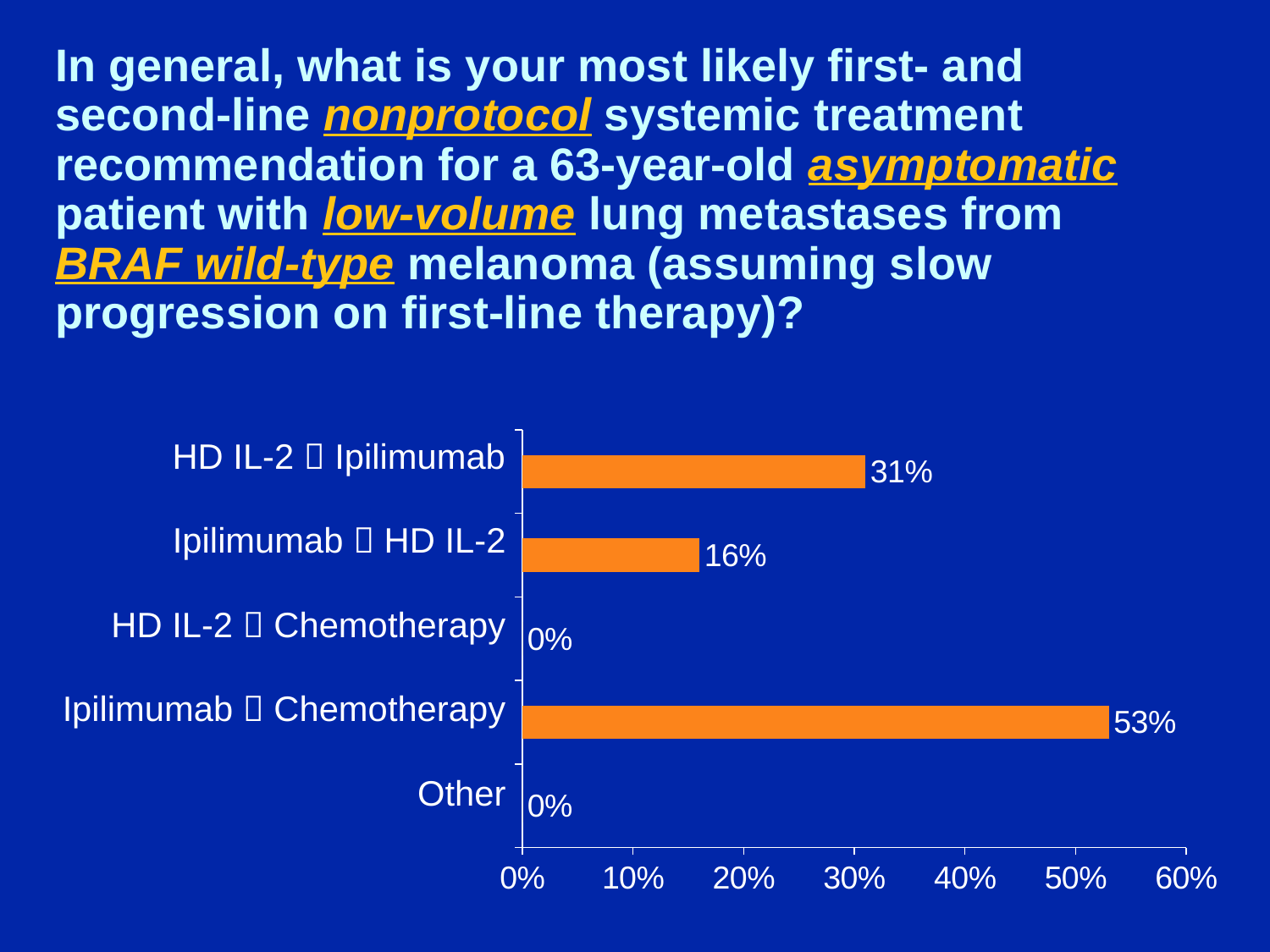
What is the difference in percentage points between HD IL-2 followed by Ipilimumab and Ipilimumab followed by HD IL-2? 15% Which treatment sequence received the highest percentage of responses? Ipilimumab followed by Chemotherapy What is the difference in percentage points between Ipilimumab followed by Chemotherapy and HD IL-2 followed by Ipilimumab? 22% What type of chart is shown on the slide? Bar chart What percentage of respondents chose HD IL-2 followed by Chemotherapy? 0% Which received a higher percentage: HD IL-2 followed by Ipilimumab or Ipilimumab followed by HD IL-2? HD IL-2 followed by Ipilimumab What percentage of respondents chose Ipilimumab followed by Chemotherapy? 53% How many treatment options are shown on the chart? 5 What percentage of respondents chose HD IL-2 followed by Ipilimumab? 31% What percentage of respondents chose Ipilimumab followed by HD IL-2? 16% Is the value for Ipilimumab followed by Chemotherapy greater or less than 50%? greater What percentage of respondents chose Other? 0%